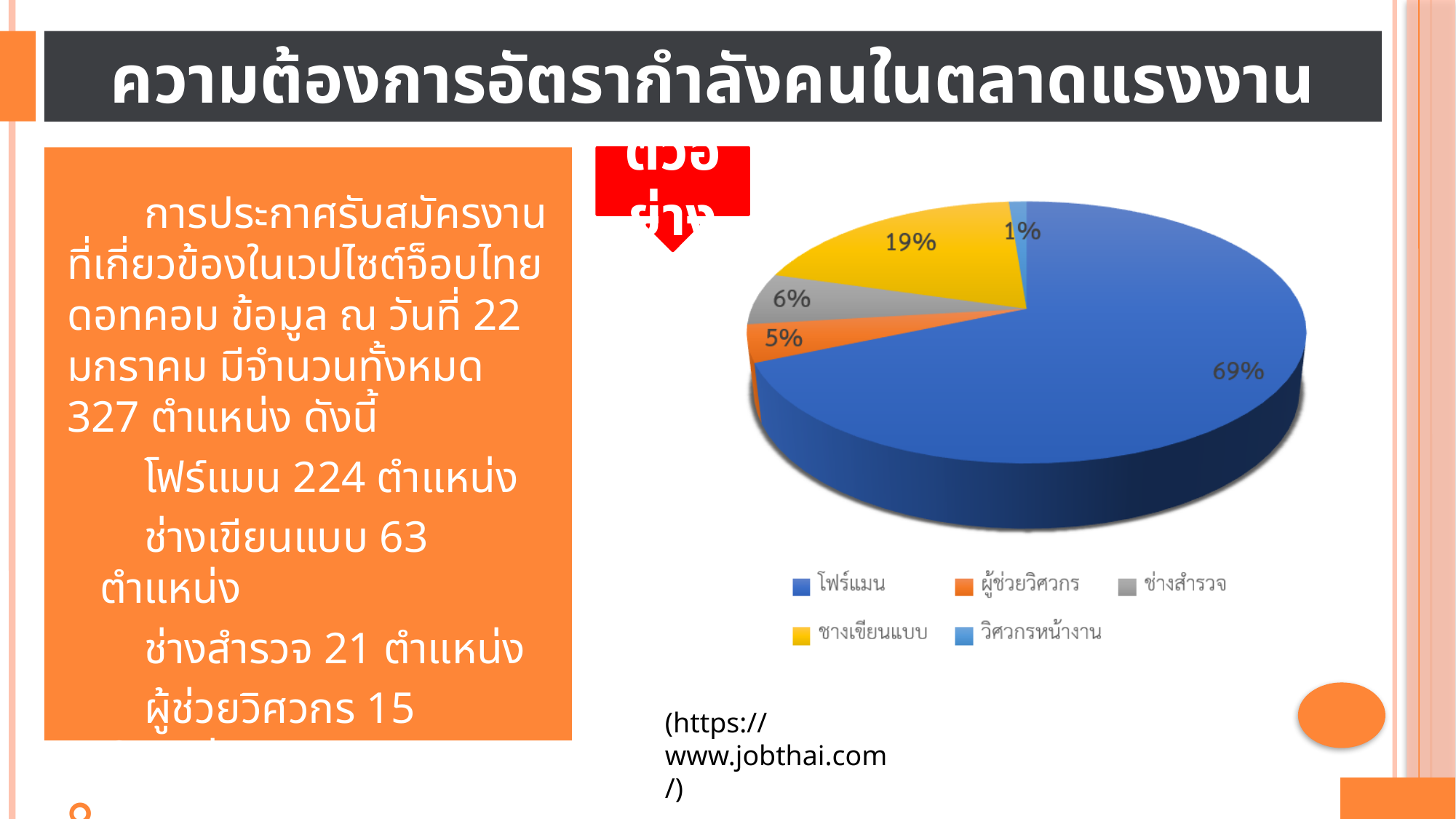
By how many percentage points does the โฟร์แมน slice exceed the ช่างเขียนแบบ slice? 50 percentage points What is the value shown for วิศวกรหน้างาน in the pie chart? 1% How many entries does the legend of the pie chart list? 5 What colour is the โฟร์แมน slice in the pie chart? Blue Which category has the smallest slice in the pie chart? วิศวกรหน้างาน Which category has the largest slice in the pie chart? โฟร์แมน How many slices does the pie chart have? 5 What kind of chart is shown on the slide? Pie chart What share of the pie chart does ช่างเขียนแบบ take? 19% What is the value shown for ช่างสำรวจ in the pie chart? 6% What share of the pie chart does โฟร์แมน take? 69% What is the value shown for ผู้ช่วยวิศวกร in the pie chart? 5%